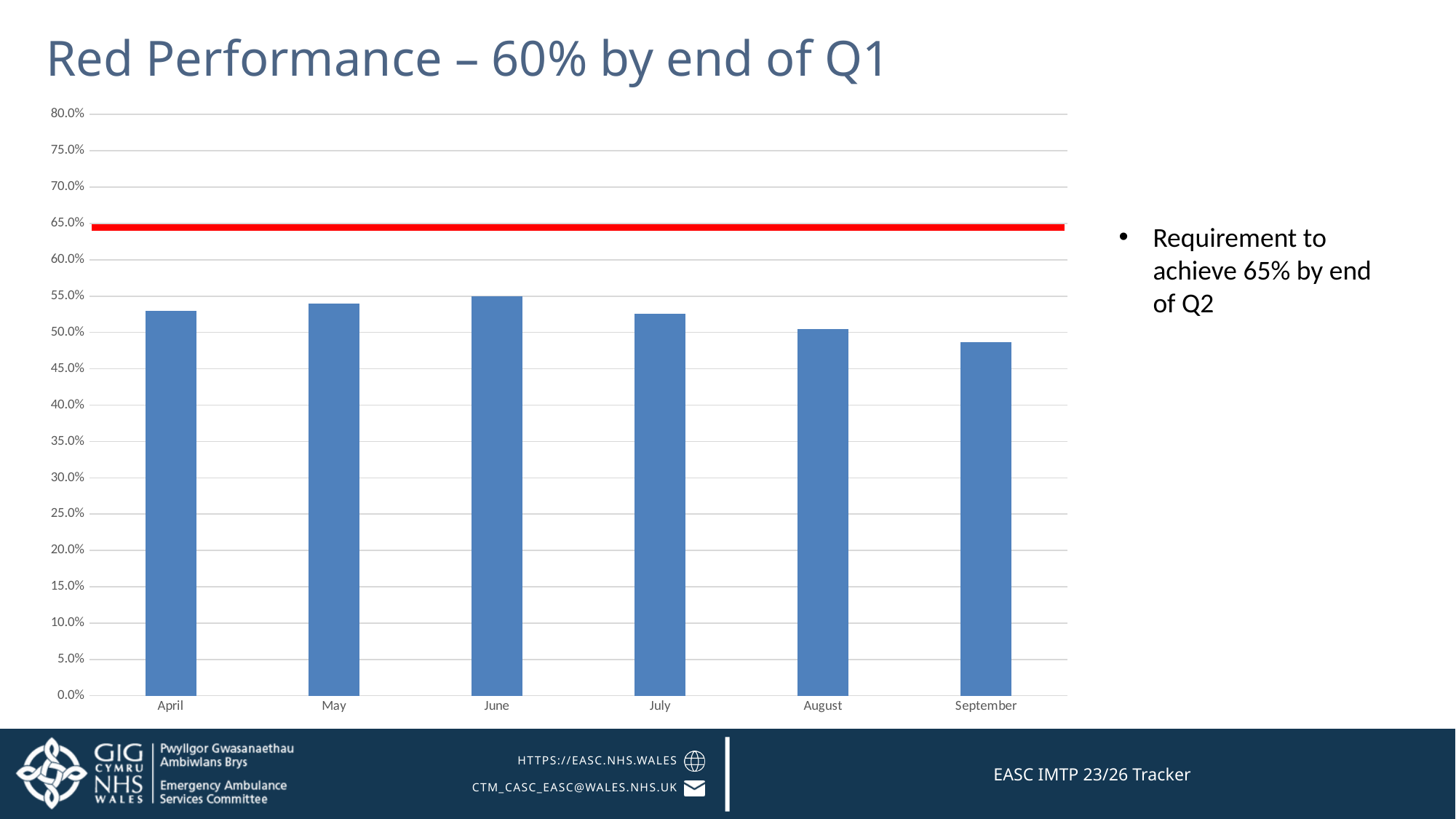
Which is larger, the value for June or the value for September? June What is the title of the slide containing the chart? Red Performance – 60% by end of Q1 Is the value for July greater or less than 55.0%? less Is the value for June greater or less than 60.0%? less Do the values rise or fall from June to September? fall Which month has the lowest bar? September What kind of chart is shown on the slide? bar chart Is the value for August greater or less than 45.0%? greater Which month has the highest bar? June How many months are plotted on the x axis? 6 At what axis value is the horizontal red line drawn? 65.0%